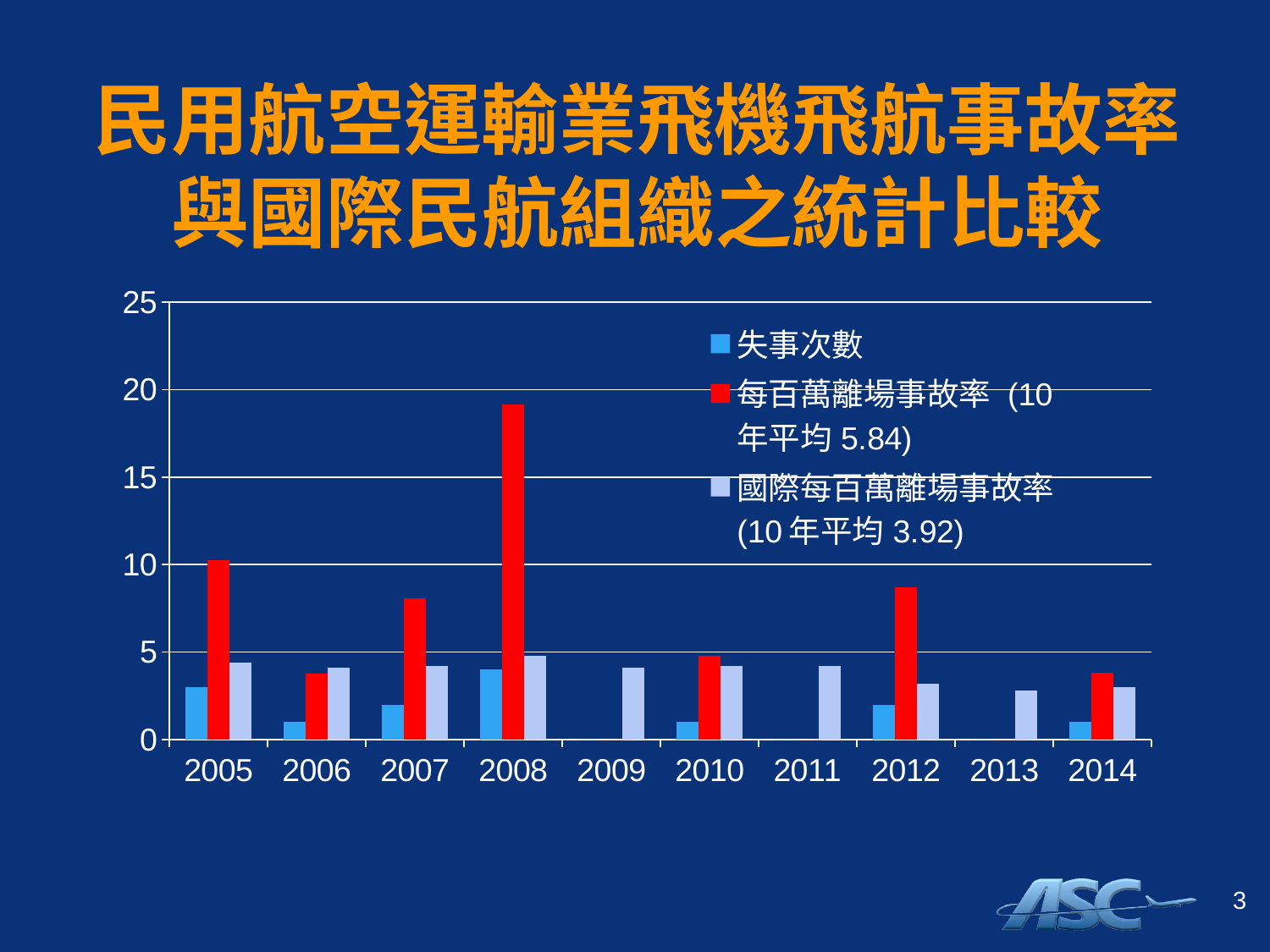
What 10-year average is given in the legend for 國際每百萬離場事故率? 3.92 Is the 每百萬離場事故率 value for 2008 greater or less than 15? greater In which year is the 失事次數 (blue) bar highest? 2008 What kind of chart is shown on the slide? bar chart In which year is the 每百萬離場事故率 (red) bar highest? 2008 Is the 失事次數 value for 2008 greater or less than 5? less Which is larger, the 每百萬離場事故率 value for 2005 or for 2012? 2005 In which year is the 國際每百萬離場事故率 (light blue) bar lowest? 2013 How many years are shown on the x axis? 10 Is the 每百萬離場事故率 value for 2012 greater or less than 10? less How many series does the legend list? 3 What 10-year average is given in the legend for 每百萬離場事故率? 5.84